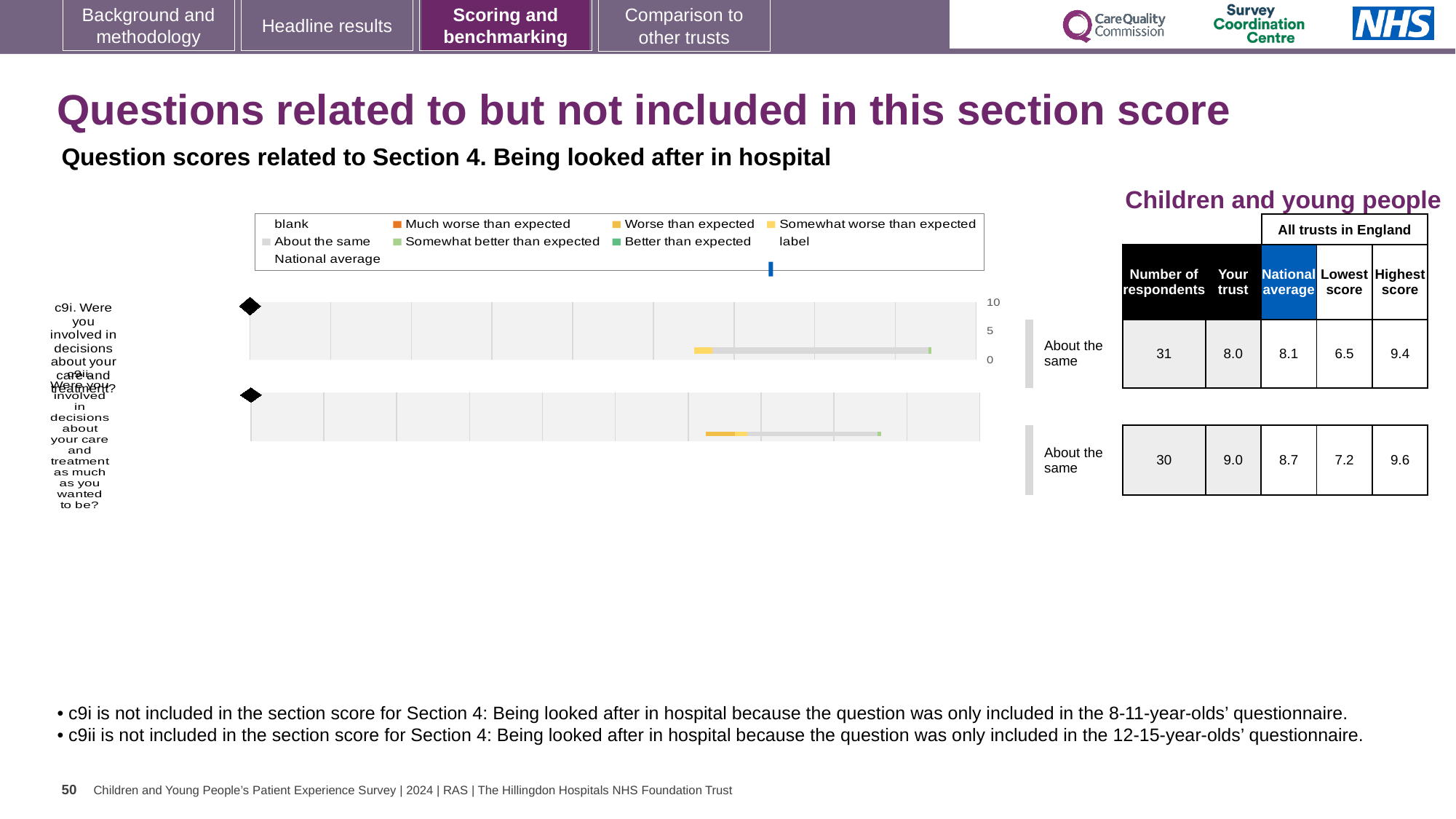
What is the 'Your trust' score for c9ii (Were you involved in decisions about your care and treatment as much as you wanted to be?)? 9.0 How many questions are plotted in the chart? 2 What kind of chart is used to show the question scores for c9i and c9ii? bar chart What is the national average score for c9i? 8.1 What is the difference between the highest score and the lowest score across all trusts in England for c9i? 2.9 Which question has the higher 'Your trust' score, c9i or c9ii? c9ii What benchmark category is shown for c9i? About the same What is the 'Your trust' score for c9i (Were you involved in decisions about your care and treatment?)? 8.0 What is the lowest score across all trusts in England for c9ii? 7.2 What is the subtitle describing the chart's content? Question scores related to Section 4. Being looked after in hospital How many respondents answered c9ii? 30 By how much does the trust's score for c9ii exceed the national average for c9ii? 0.3